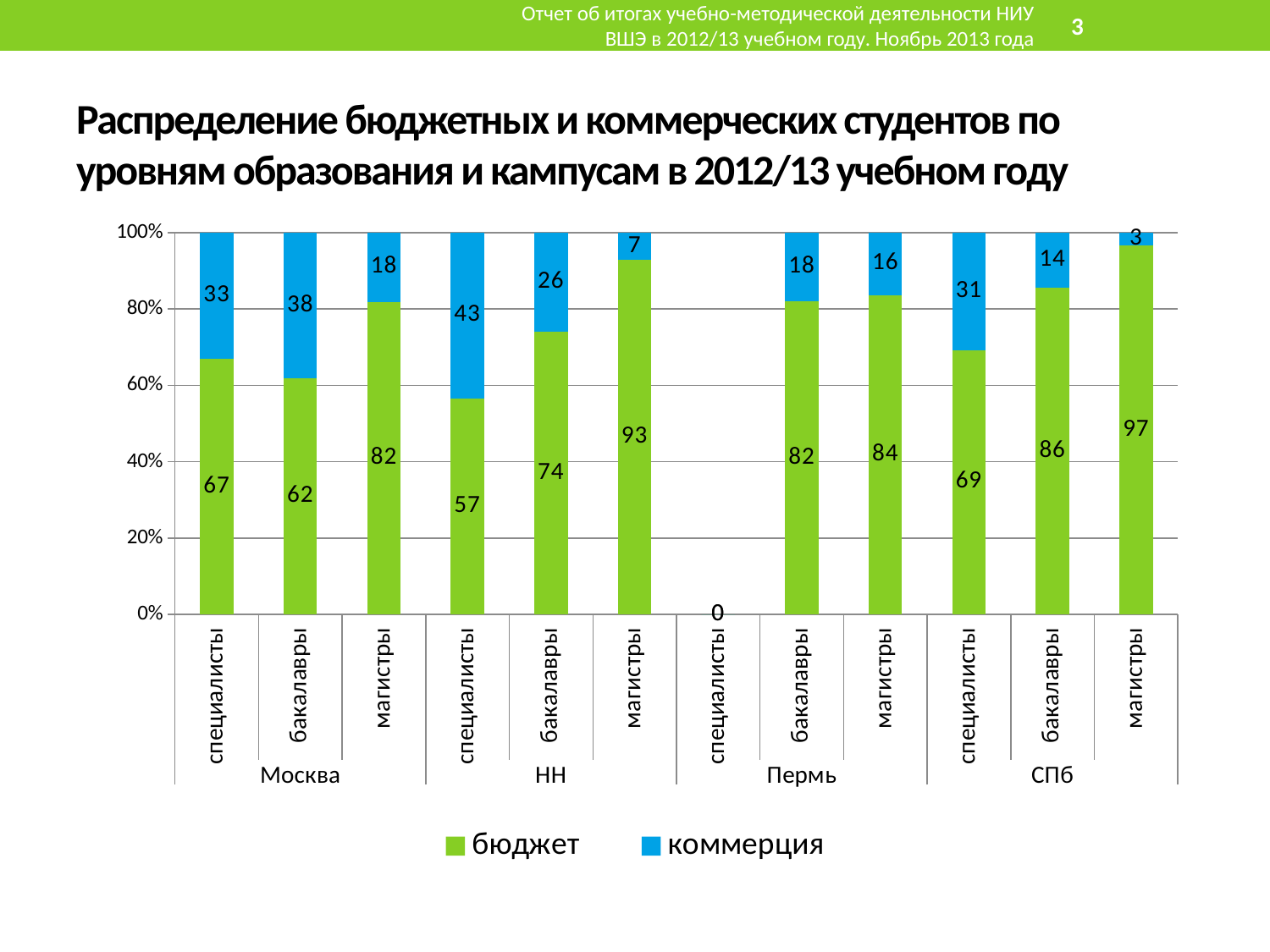
What kind of chart is shown on the slide? stacked bar chart What is the коммерция value for специалисты in НН? 43 How many series does the legend list? 2 How many campuses (category groups) are shown on the x axis? 4 Among the bars with a non-zero бюджет value, which has the lowest бюджет value? специалисты (НН) Which is larger: the коммерция value for специалисты in Москва or for специалисты in СПб? специалисты in Москва What is the бюджет value for магистры in Москва? 82 What is the difference between the бюджет values for бакалавры in СПб and бакалавры in Москва? 24 What is the коммерция value for бакалавры in Пермь? 18 Which colour represents the коммерция series? blue What is the бюджет value for магистры in СПб? 97 Which bar has the highest бюджет value? магистры (СПб)